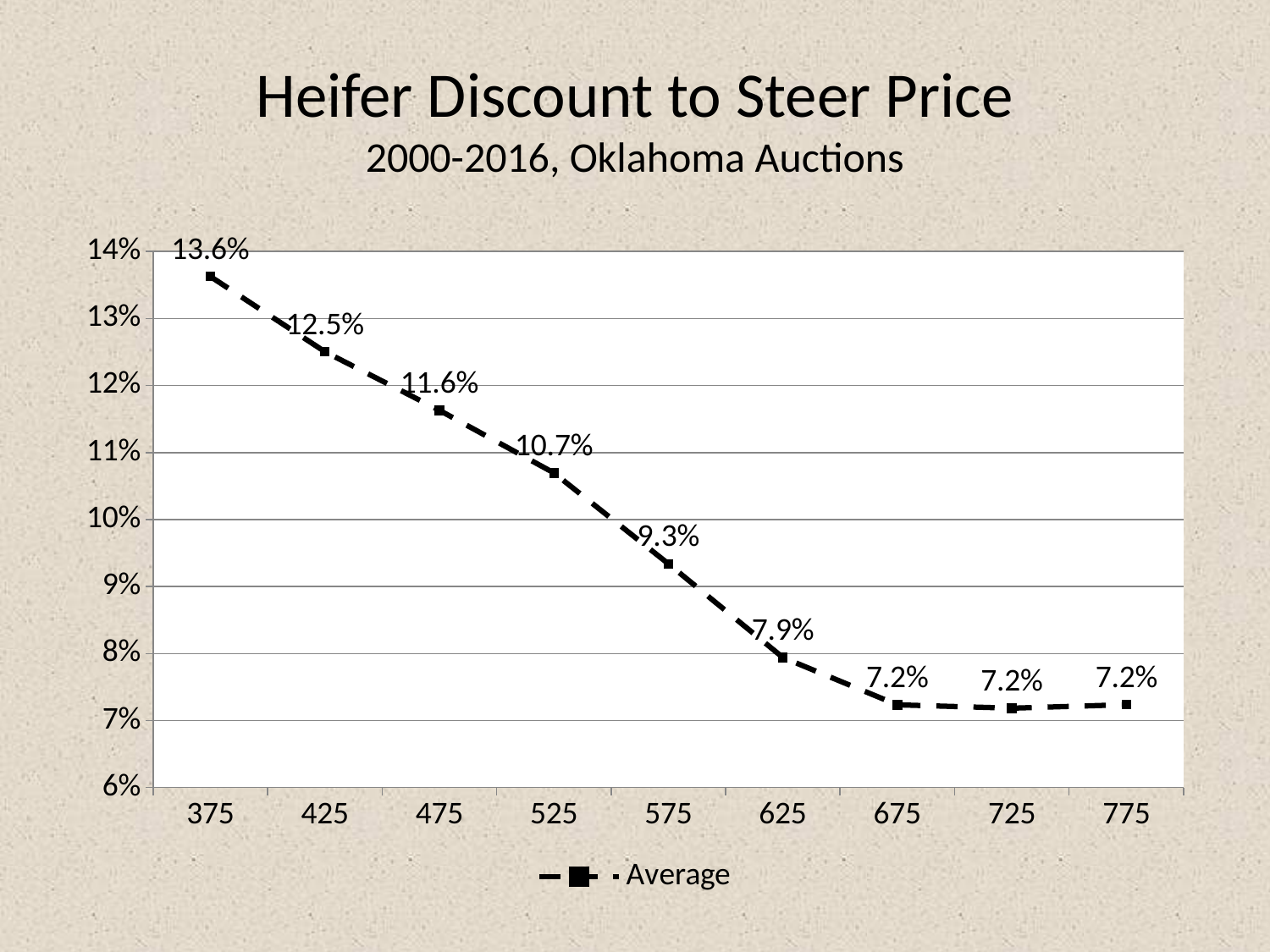
Which weight category has the highest average heifer discount? 375 Do the average discount values rise or fall as weight increases from 375 to 675? fall What is the average heifer discount at the 525 weight category? 10.7% How many weight categories are plotted on the x axis? 9 How many series does the legend list? 1 What is the difference between the average discount at 575 and at 625? 1.4% Is the average discount at 525 greater or less than 10%? greater Which is larger, the average discount at 475 or at 575? 475 What is the average heifer discount at the 375 weight category? 13.6% What is the average heifer discount at the 625 weight category? 7.9% What kind of chart is shown on the slide? line chart What is the difference between the average discount at 375 and at 425? 1.1%